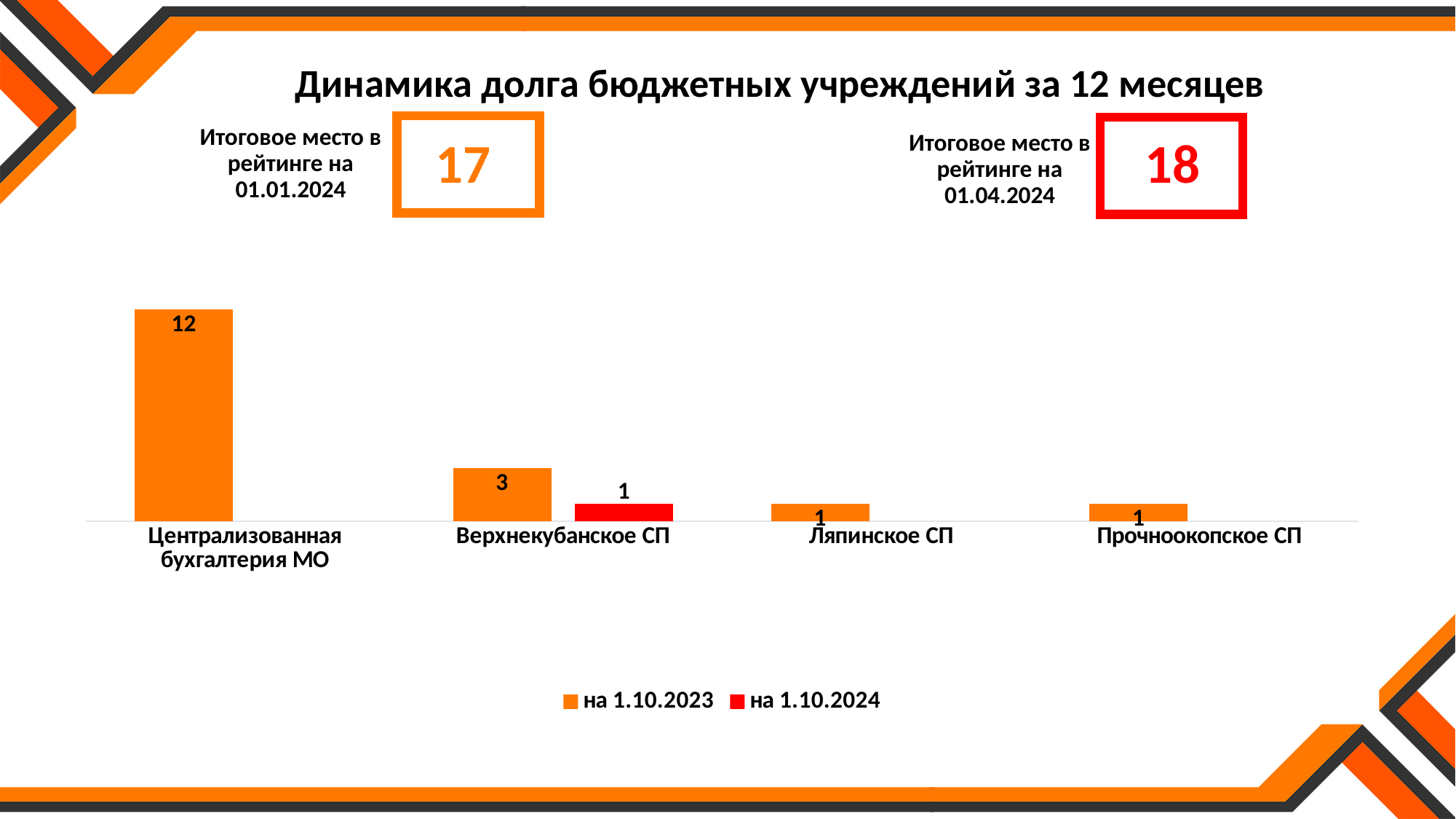
How many categories are shown on the x axis of the chart? 4 Which is larger for Верхнекубанское СП: the value на 1.10.2023 or the value на 1.10.2024? на 1.10.2023 What is the value for Прочноокопское СП in the series на 1.10.2023? 1 What is the difference between the на 1.10.2023 values for Централизованная бухгалтерия МО and Верхнекубанское СП? 9 Which category has the highest value in the series на 1.10.2023? Централизованная бухгалтерия МО What is the value for Верхнекубанское СП in the series на 1.10.2023? 3 For Верхнекубанское СП, what is the difference between the на 1.10.2023 and на 1.10.2024 values? 2 How many series does the legend list? 2 What type of chart is shown on the slide? bar chart What is the value for Централизованная бухгалтерия МО in the series на 1.10.2023? 12 What is the value for Верхнекубанское СП in the series на 1.10.2024? 1 What is the value for Ляпинское СП in the series на 1.10.2023? 1